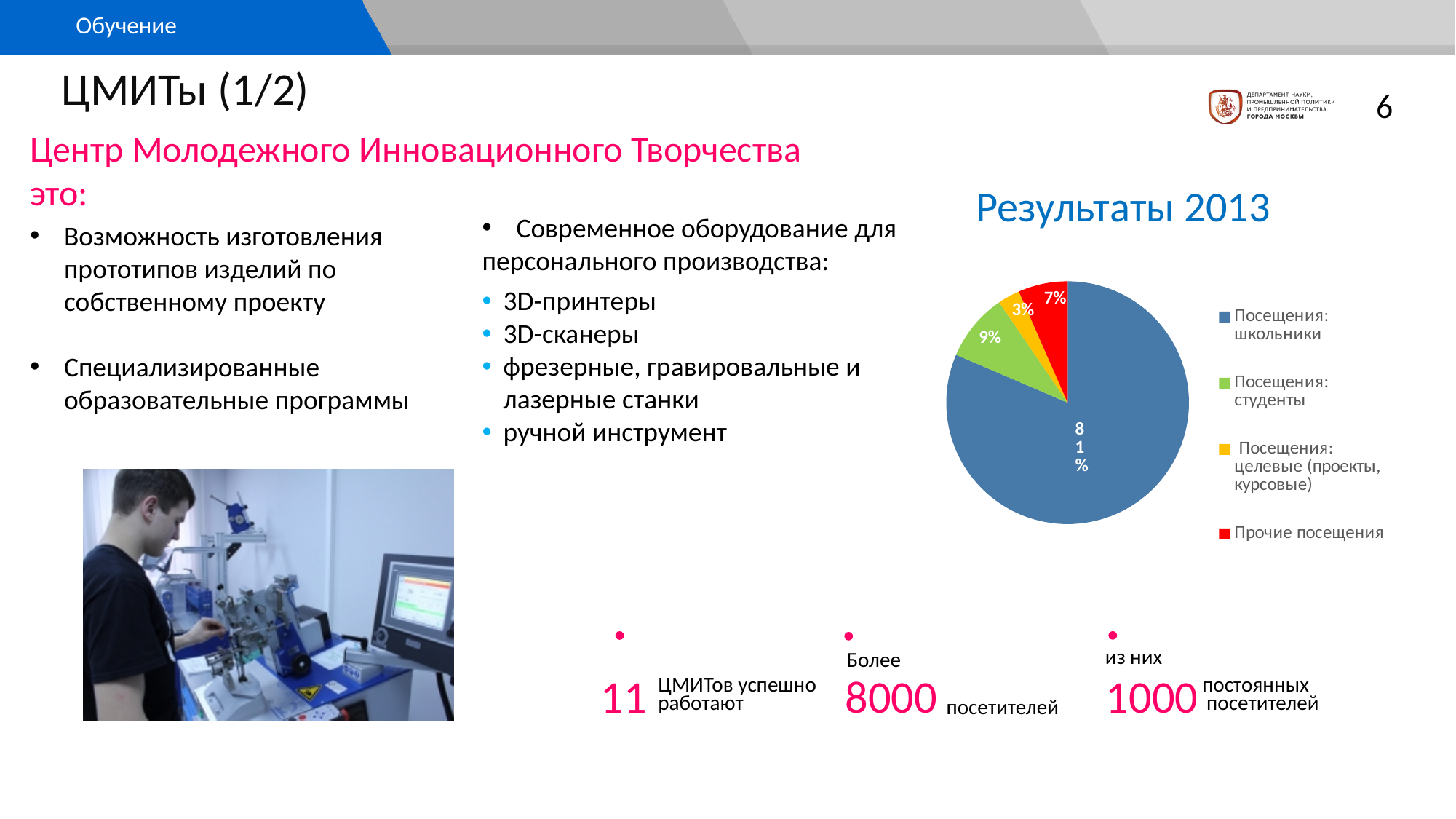
What type of chart is shown under the title "Результаты 2013"? Pie chart How many categories does the pie chart show? 4 Which is larger in the pie chart: "Прочие посещения" or "Посещения: целевые (проекты, курсовые)"? Прочие посещения What share of the pie chart is "Прочие посещения"? 7% What share of the pie chart is "Посещения: целевые (проекты, курсовые)"? 3% What is the title of the pie chart on the slide? Результаты 2013 What is the difference in percentage points between "Посещения: студенты" and "Прочие посещения"? 2% What colour is the "Посещения: студенты" slice in the pie chart? Green What share of the pie chart is "Посещения: студенты"? 9% Which category has the smallest slice in the pie chart? Посещения: целевые (проекты, курсовые) Which category has the largest slice in the pie chart? Посещения: школьники What share of the pie chart is "Посещения: школьники"? 81%